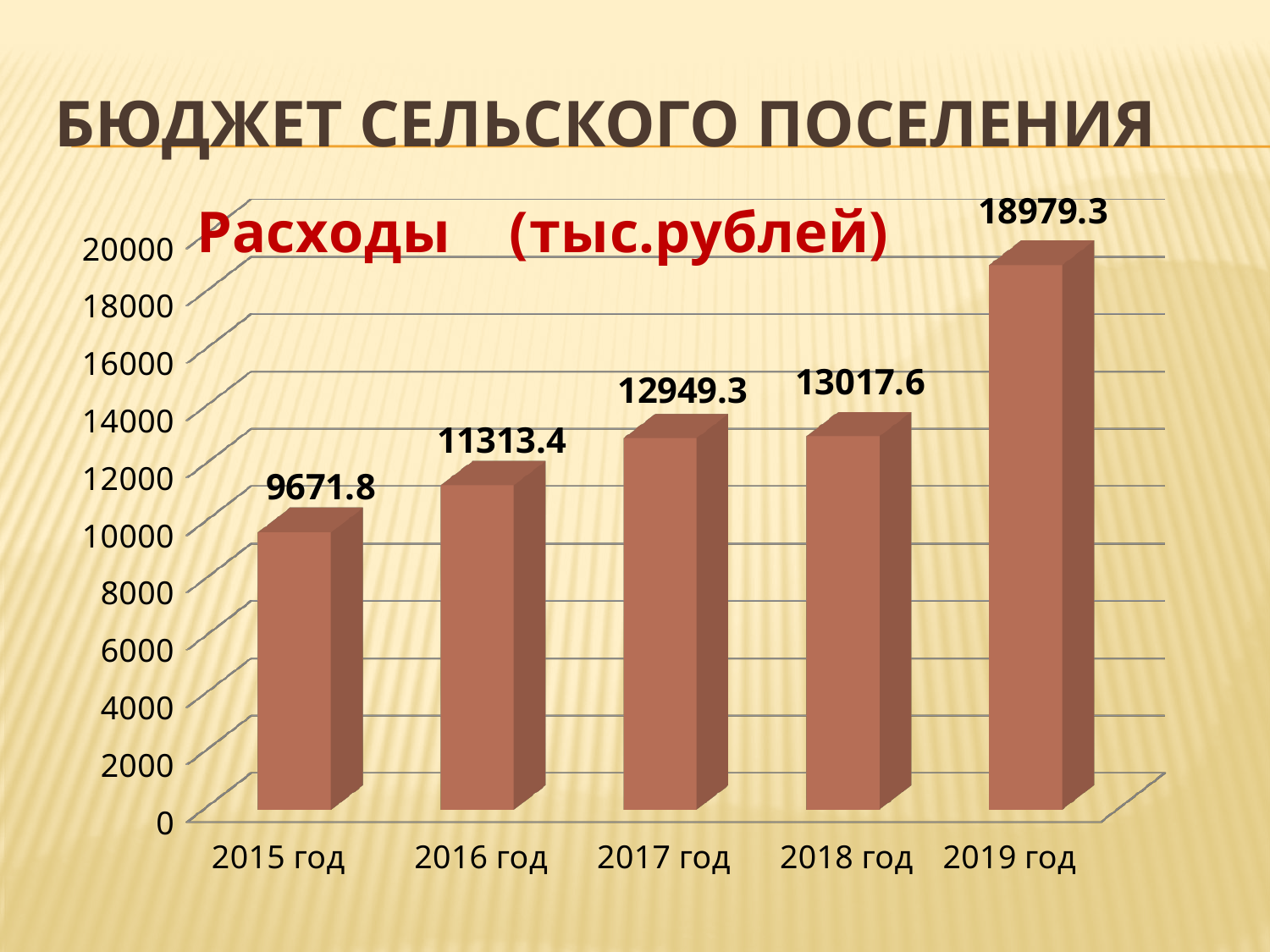
What is the value for 2017 год? 12949.3 What is the difference between the values for 2019 год and 2018 год? 5961.7 How many years are shown on the chart? 5 Which is larger, the value for 2016 год or the value for 2017 год? 2017 год What is the value for 2015 год? 9671.8 Is the value for 2018 год greater or less than 12000? greater Do the values rise or fall from 2015 год to 2019 год? rise What is the value for 2019 год? 18979.3 Which year has the lowest value? 2015 год What kind of chart is shown on the slide? bar chart What is the difference between the values for 2016 год and 2015 год? 1641.6 Which year has the highest value? 2019 год